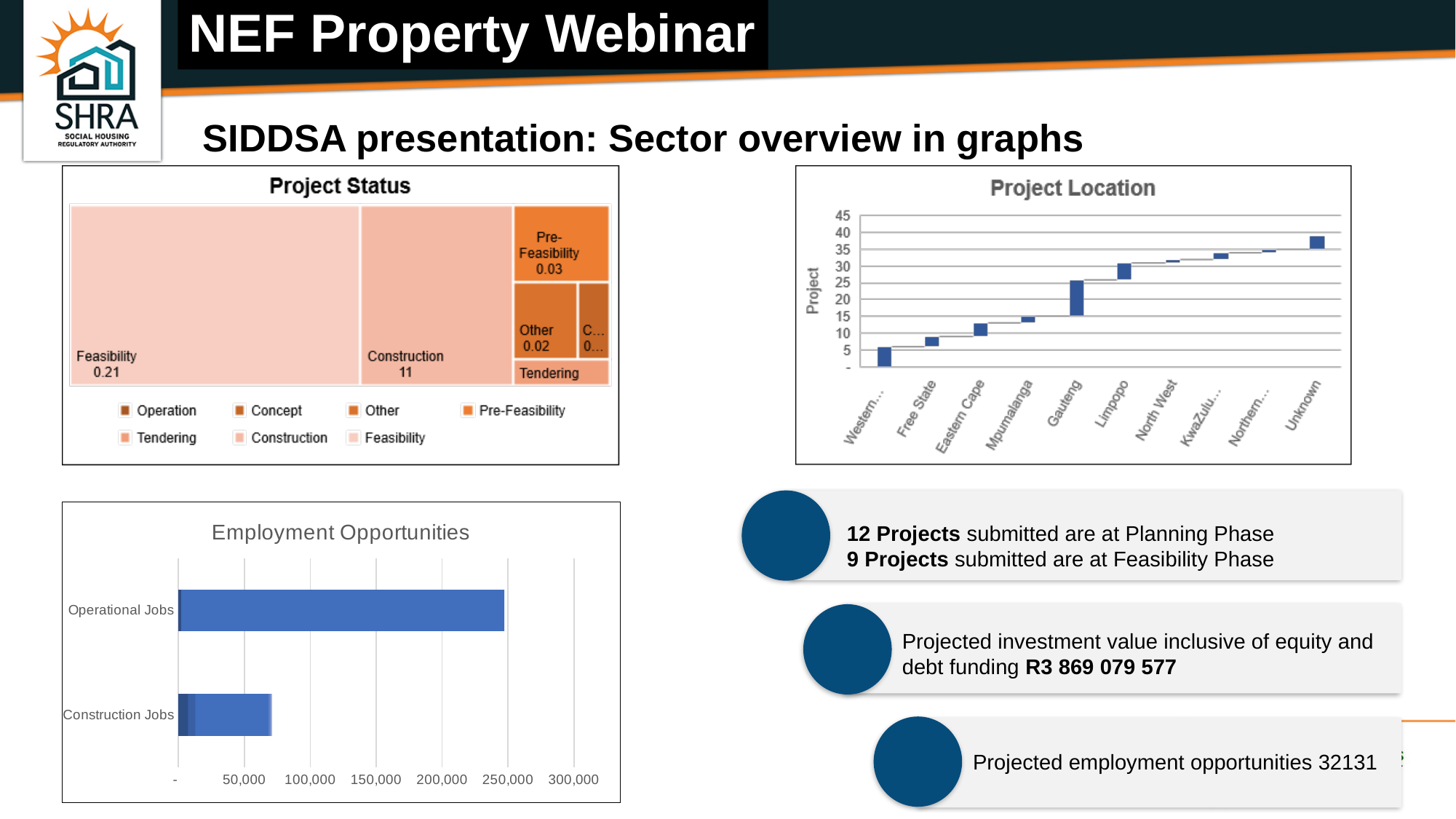
In the Project Location chart, does the cumulative level rise or fall from left to right along the x axis? rise What kind of chart is the Employment Opportunities chart? bar chart In the Employment Opportunities chart, is the value for Construction Jobs greater or less than 100,000? less In the Project Status chart, which is larger, the value for Pre-Feasibility or the value for Other? Pre-Feasibility In the Project Status chart, what value is shown for Pre-Feasibility? 0.03 In the Project Location chart, what is the label of the y axis? Project In the Project Status chart, how many entries does the legend list? 7 In the Project Status chart, what value is shown for Other? 0.02 In the Project Location chart, how many categories are shown on the x axis? 10 In the Project Status chart, what value is shown for Construction? 11 In the Project Status chart, what value is shown for Feasibility? 0.21 In the Employment Opportunities chart, is the value for Operational Jobs greater or less than 200,000? greater